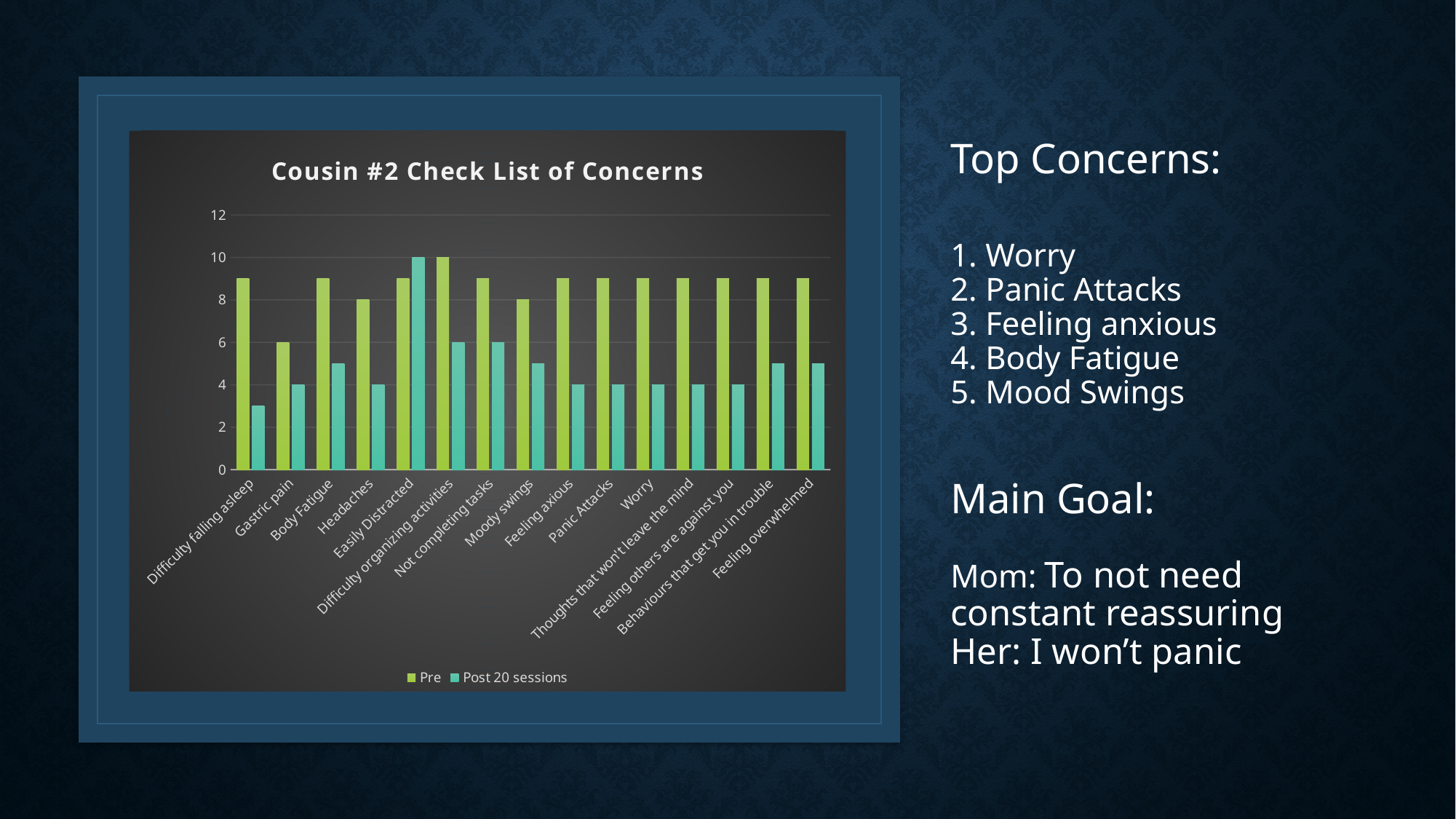
What is the Pre value for Difficulty organizing activities? 10 How many concern categories are plotted on the x axis? 15 What is the Post 20 sessions value for Easily Distracted? 10 How many series does the chart legend list? 2 What is the Pre value for Headaches? 8 What is the Post 20 sessions value for Worry? 4 Which category has the highest Pre value? Difficulty organizing activities Which category has the lowest Post 20 sessions value? Difficulty falling asleep Is the Post 20 sessions value for Difficulty falling asleep greater or less than 4? less What kind of chart is shown on the slide? bar chart For Easily Distracted, which is larger: the Pre value or the Post 20 sessions value? Post 20 sessions What is the title of the chart? Cousin #2 Check List of Concerns